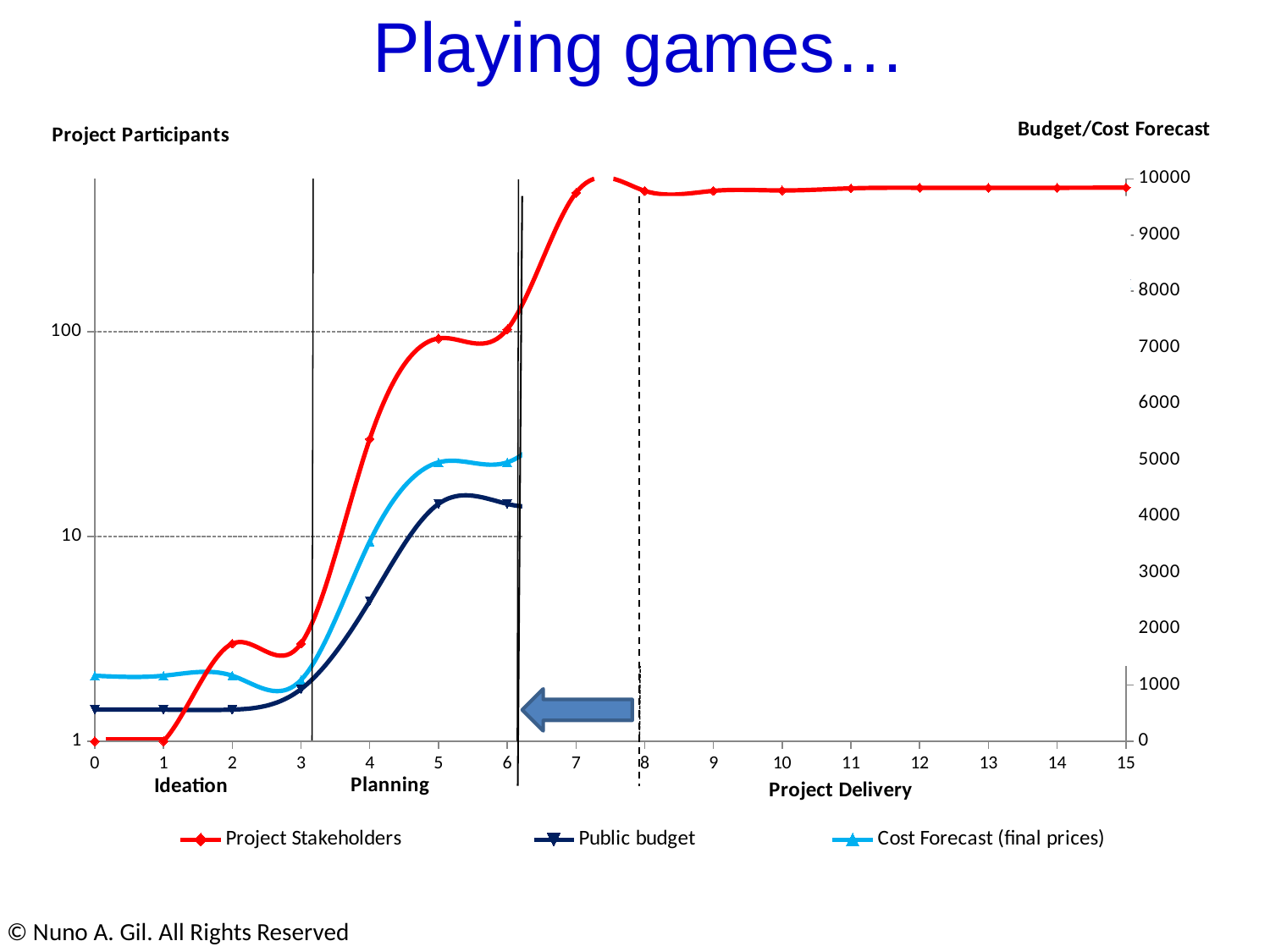
How many series does the legend list? 3 Is the value for Public budget at x = 5 greater or less than 3000 on the right axis? greater What are the three project phases labelled along the x axis? Ideation, Planning, Project Delivery What is the value of Project Stakeholders at x = 0? 1 Is the value for Public budget at x = 0 greater or less than 1000 on the right axis? less What kind of chart is shown on the slide? line chart At x = 5, which is higher: Cost Forecast (final prices) or Public budget? Cost Forecast (final prices) Is the value for Project Stakeholders at x = 2 greater or less than 10? less Does the Project Stakeholders line rise or fall between x = 1 and x = 7? rise Which series are listed in the legend? Project Stakeholders, Public budget, Cost Forecast (final prices) What is the value of Project Stakeholders at x = 1? 1